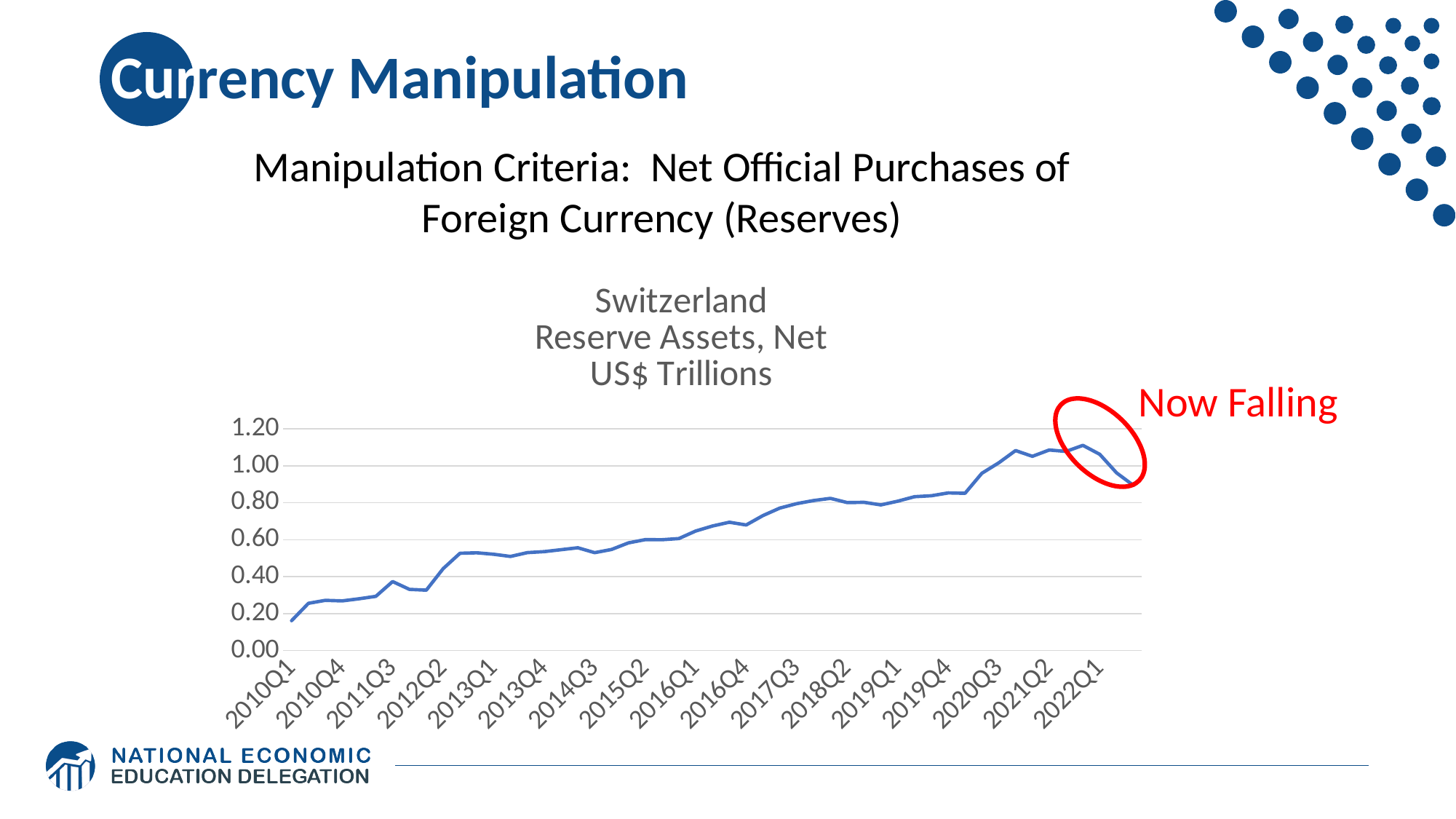
Which is larger, the value for 2013Q1 or the value for 2019Q1? 2019Q1 Is the value for 2014Q3 greater or less than 0.40? greater Is the value for 2018Q2 greater or less than 0.60? greater Which is larger, the value for 2010Q1 or the value for 2022Q1? 2022Q1 What is the title of the chart? Switzerland Reserve Assets, Net US$ Trillions Overall, do the values rise or fall from 2010Q1 to 2021Q2? rise Is the value for 2013Q1 greater or less than 0.40? greater What does the red annotation next to the circled end of the line say? Now Falling How many quarter labels are shown on the x axis? 17 What kind of chart is shown on the slide? line chart